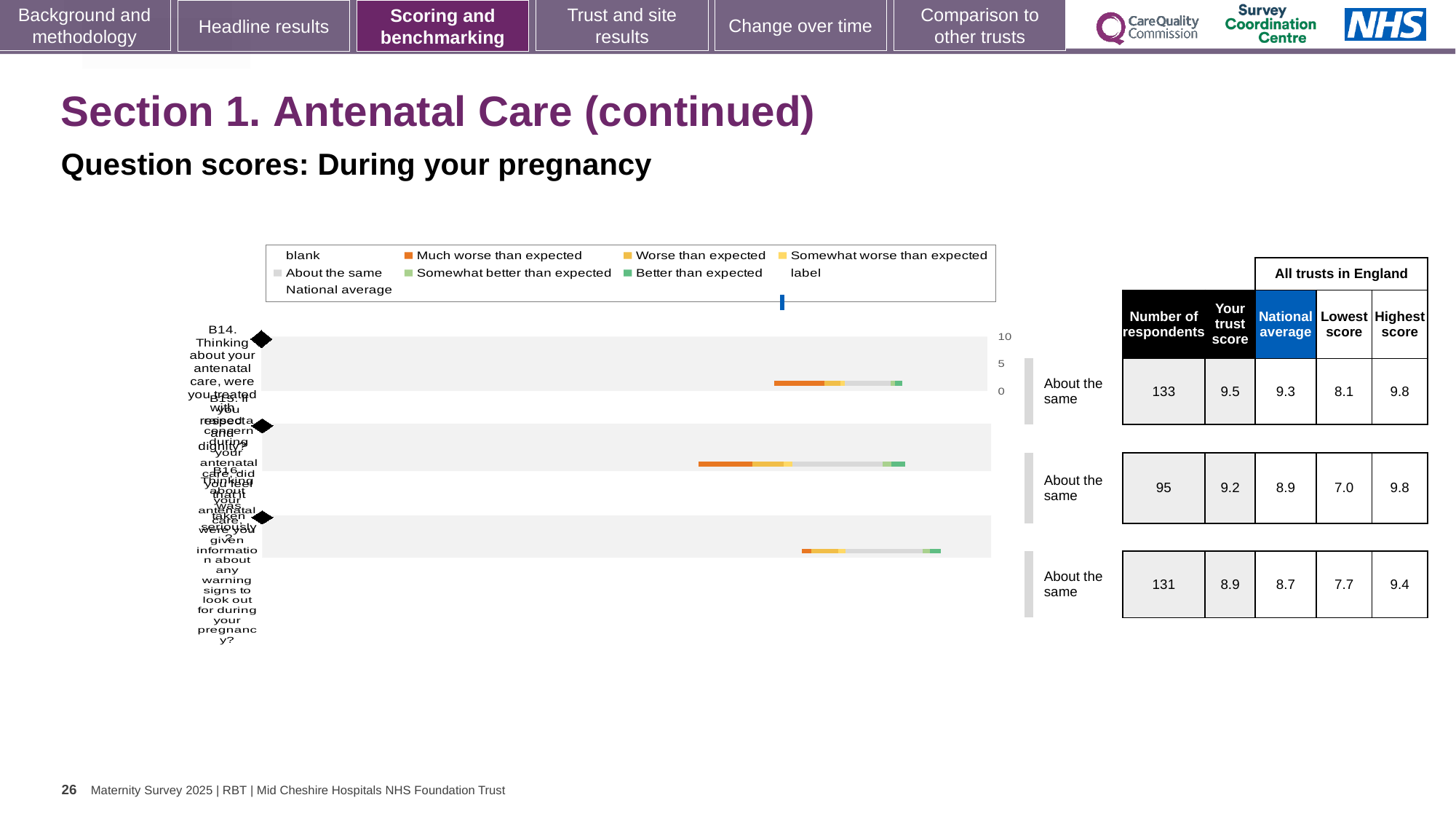
Which colour does the legend use for 'Much worse than expected'? orange What benchmark category is shown next to each of the three bars? About the same Which of the three questions has the lowest 'Lowest score' value in the table? B15 (second row), 7.0 For the second question (B15), what is the difference between 'Your trust score' (9.2) and the national average (8.9)? 0.3 In the table beside the chart, what is the national average for the third question (B16)? 8.7 What kind of chart is shown on the slide? bar chart In the table beside the chart, what is the 'Your trust score' for the first question (B14, treated with respect and dignity)? 9.5 How many survey questions (bars) are plotted in the chart? 3 In the table beside the chart, how many respondents are listed for the first question (B14)? 133 Which of the three questions has the highest 'Your trust score' in the table? B14 (first row), 9.5 For the first question (B14), is 'Your trust score' or the national average larger? Your trust score (9.5) What is the highest tick value shown on the chart's numeric axis? 10